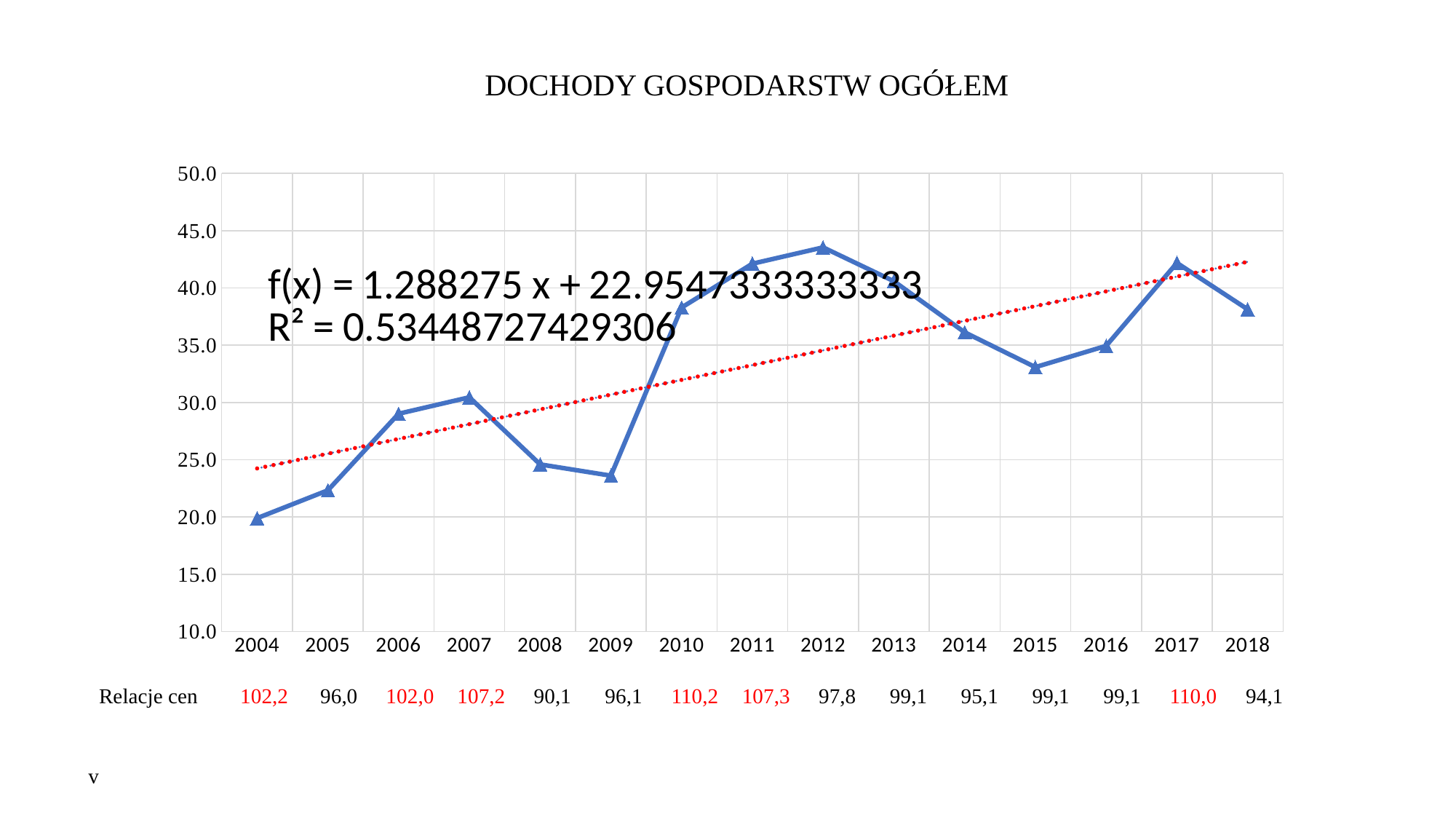
What R² value is shown for the trendline on the chart? 0.53448727429306 Which year has the larger value, 2007 or 2008? 2007 What kind of chart is shown on the slide? line chart Is the value for 2015 greater or less than 35? less Is the value for 2017 greater or less than 40? greater Is the value for 2010 greater or less than 35? greater In which year does the line reach its highest value? 2012 How many years are shown on the x axis of the chart? 15 In which year does the line have its lowest value? 2004 What is the title of the chart? DOCHODY GOSPODARSTW OGÓŁEM Which year has the larger value, 2014 or 2015? 2014